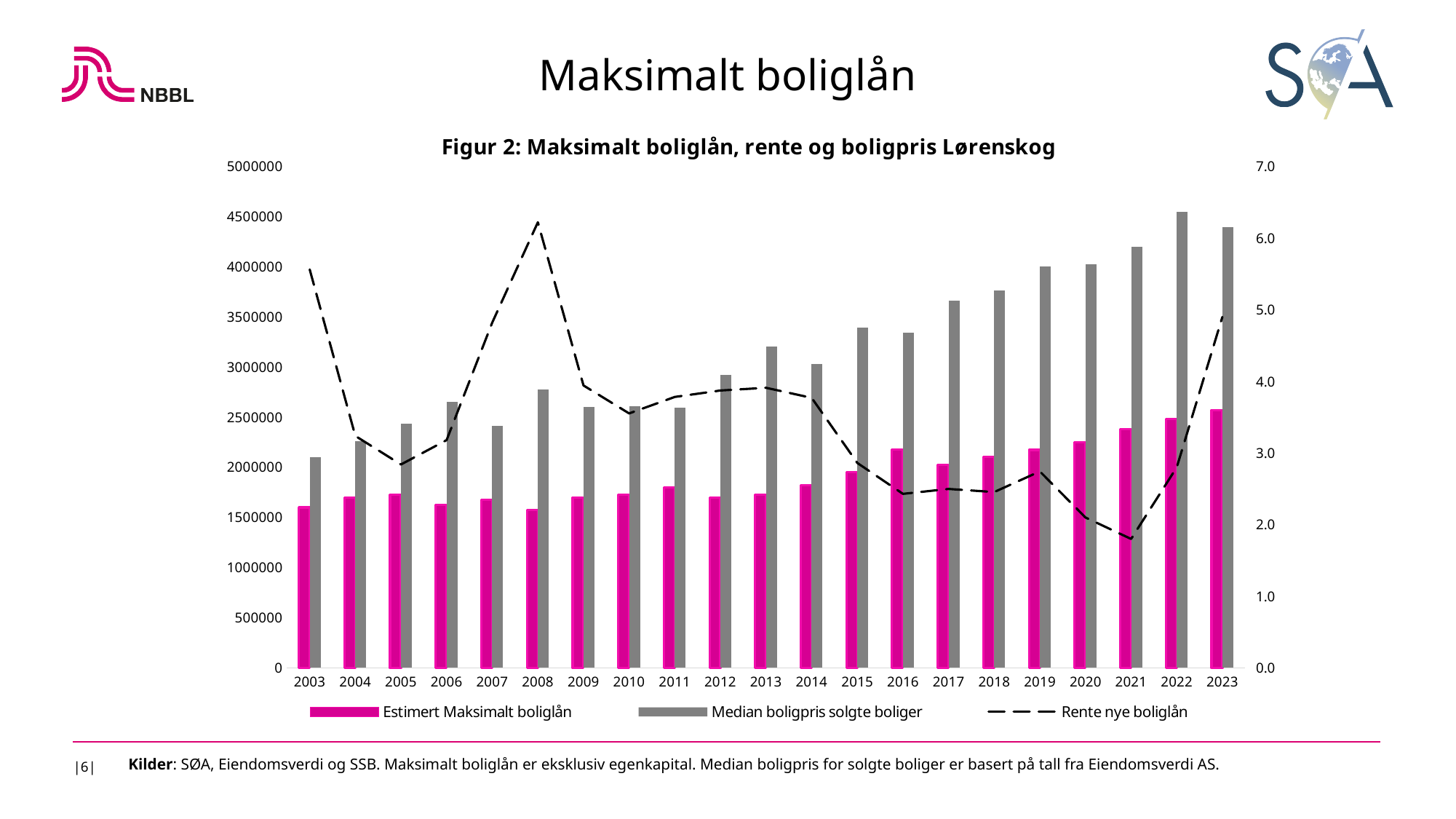
Which is larger, Median boligpris solgte boliger in 2022 or in 2023? 2022 In which year is Estimert Maksimalt boliglån highest? 2023 Does Estimert Maksimalt boliglån generally rise or fall from 2003 to 2023? rise How many series does the legend of Figur 2 list? 3 Is the value of Median boligpris solgte boliger in 2022 greater or less than 4000000? greater In which year is Rente nye boliglån lowest? 2021 What kind of chart is shown in Figur 2? A combined bar and line chart In which year is Median boligpris solgte boliger highest? 2022 In which year is Rente nye boliglån highest? 2008 How many years are shown on the x axis of Figur 2? 21 In which year is Median boligpris solgte boliger lowest? 2003